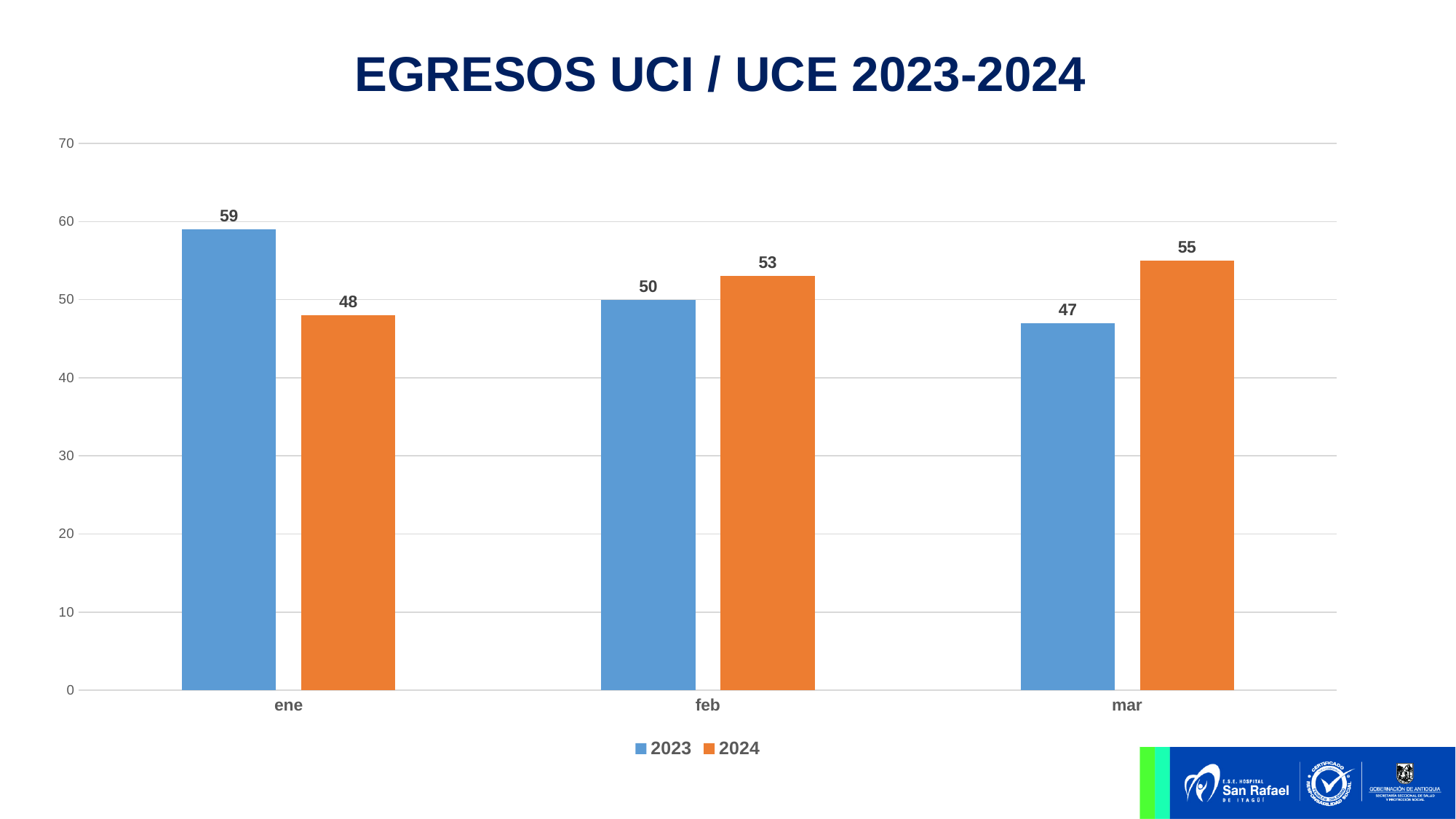
Which month has the highest value for the 2024 series? mar Which month has the lowest value for the 2023 series? mar What is the value for 2023 in ene? 59 What is the value for 2024 in mar? 55 What is the value for 2024 in feb? 53 How many series does the legend list? 2 What kind of chart is shown on the slide? bar chart What is the difference between the 2024 and 2023 values in mar? 8 Do the values for the 2023 series rise or fall from ene to mar? fall In feb, which series has the larger value, 2023 or 2024? 2024 What is the difference between the 2023 and 2024 values in ene? 11 How many months are shown on the x axis? 3